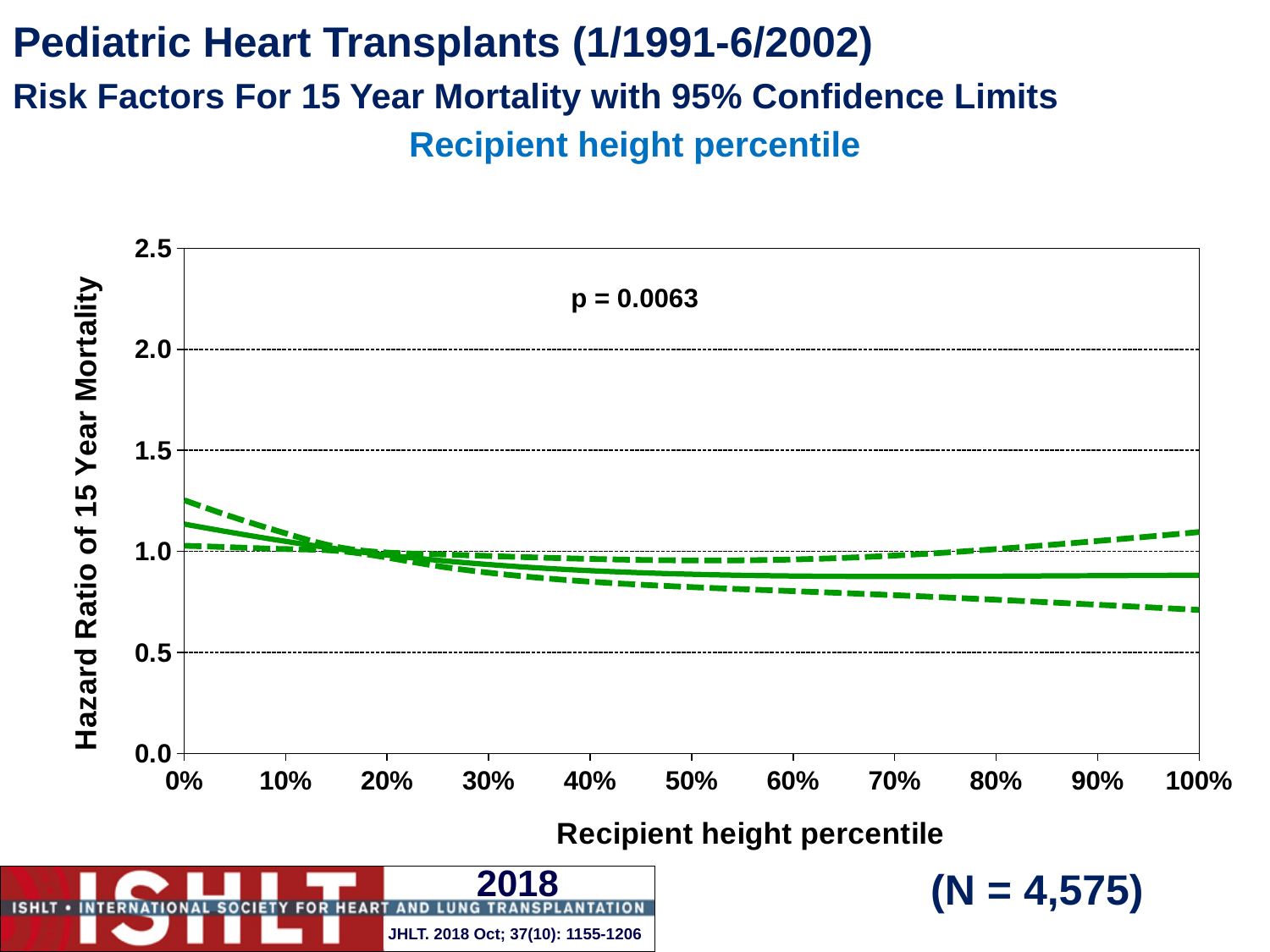
How many lines are plotted on the chart? 3 Is the solid hazard ratio line at 100% recipient height percentile greater or less than 1.0? less Is the solid hazard ratio line at 50% recipient height percentile greater or less than 1.0? less Does the solid hazard ratio line rise or fall overall from 0% to 100% recipient height percentile? falls Is the lower confidence limit at 100% recipient height percentile greater or less than 0.5? greater What sample size (N) is shown on the slide? N = 4,575 How many tick labels are shown on the x axis (Recipient height percentile)? 11 What kind of chart is shown on the slide? line chart What p-value is printed on the chart? p = 0.0063 Which has the higher hazard ratio on the solid line: 0% or 100% recipient height percentile? 0%